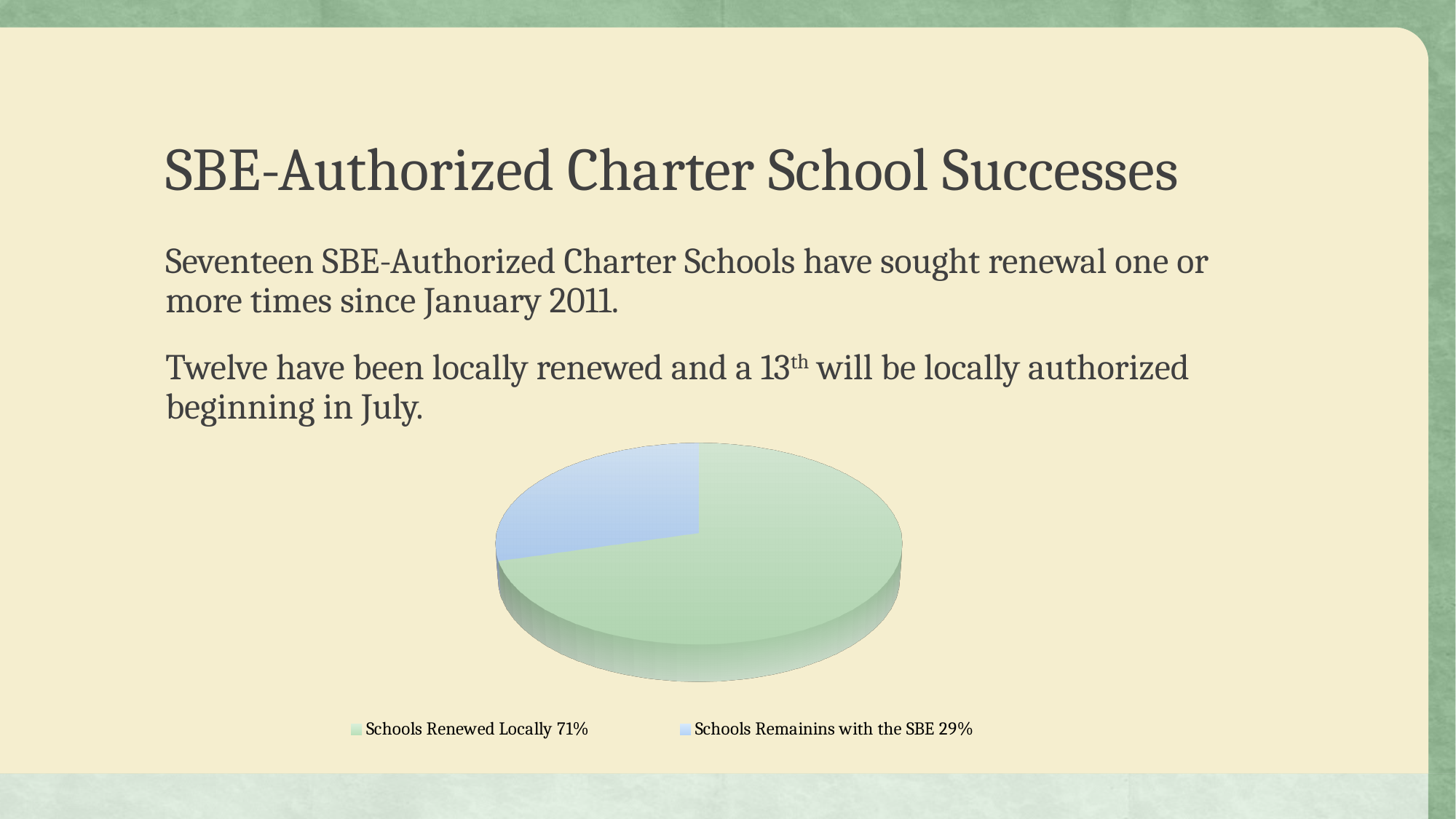
Which is larger: the Schools Renewed Locally slice or the Schools Remainins with the SBE slice? Schools Renewed Locally What share of the pie is labelled Schools Renewed Locally? 71% What share of the pie is labelled Schools Remainins with the SBE? 29% What colour is the Schools Remainins with the SBE slice in the pie chart? Blue How many slices does the pie chart have? 2 What colour is the Schools Renewed Locally slice in the pie chart? Green What is the difference in percentage points between the Schools Renewed Locally slice and the Schools Remainins with the SBE slice? 42 Which slice of the pie chart is the smallest? Schools Remainins with the SBE How many entries does the pie chart's legend list? 2 What kind of chart is shown on the slide? Pie chart Which slice of the pie chart is the largest? Schools Renewed Locally Is the share for Schools Remainins with the SBE greater or less than 50%? less